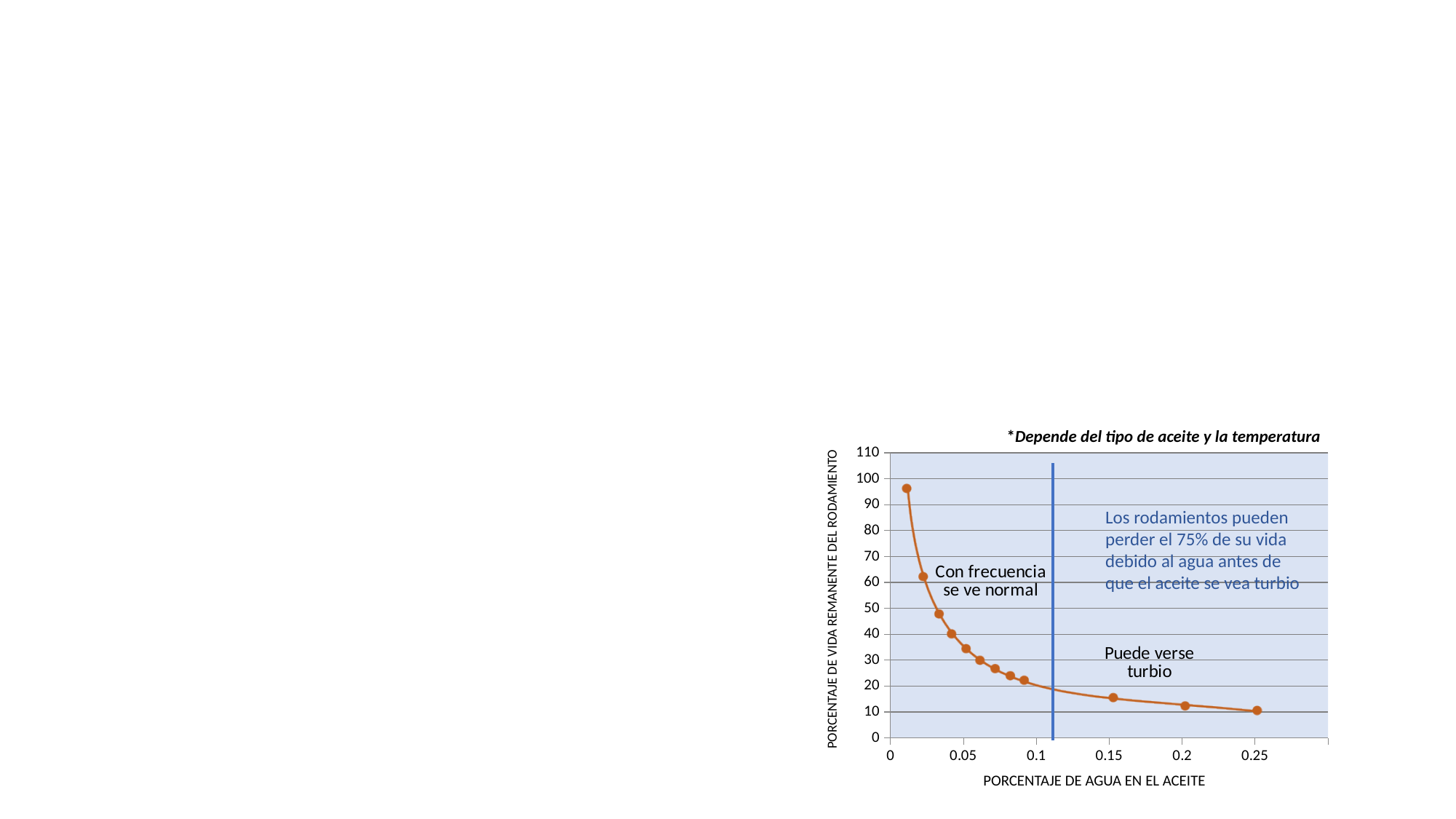
How many data points are plotted on the curve? 12 What is the title of the y axis? PORCENTAJE DE VIDA REMANENTE DEL RODAMIENTO Is the value of the data point at about 0.2 on the x axis greater or less than 10? greater What kind of chart is shown on the slide? line chart Which has the higher remaining life value: the data point at about 0.05 or the data point at about 0.2 on the x axis? the point at about 0.05 Do the plotted values rise or fall as the percentage of water in the oil increases along the x axis? fall Is the value of the data point at about 0.25 on the x axis greater or less than 20? less Is the value of the leftmost data point (near 0.01 on the x axis) greater or less than 90? greater What is the title of the x axis? PORCENTAJE DE AGUA EN EL ACEITE